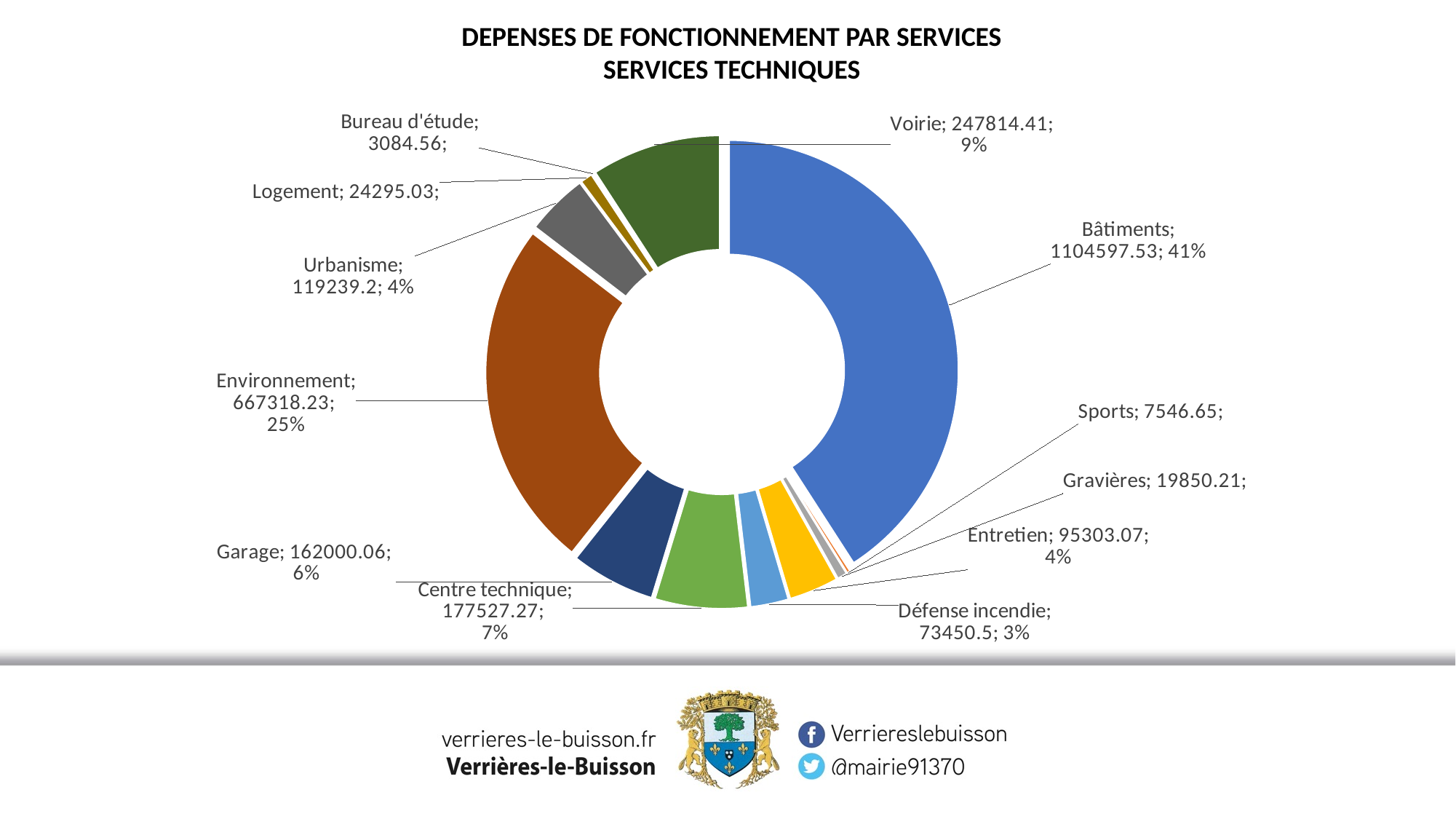
Which service has the lowest expenditure? Bureau d'étude Which service has the highest expenditure? Bâtiments Which is larger, the value for Centre technique or the value for Garage? Centre technique What is the value for Défense incendie? 73450.5 What share of the total does Environnement represent? 25% How many services (categories) are shown in the chart? 12 What type of chart is shown on the slide? Doughnut (pie) chart What is the value for Bâtiments? 1104597.53 What share of the total does Voirie represent? 9% What is the title of the chart? DEPENSES DE FONCTIONNEMENT PAR SERVICES SERVICES TECHNIQUES What is the value for Environnement? 667318.23 What is the difference between the values for Bâtiments and Environnement? 437279.3